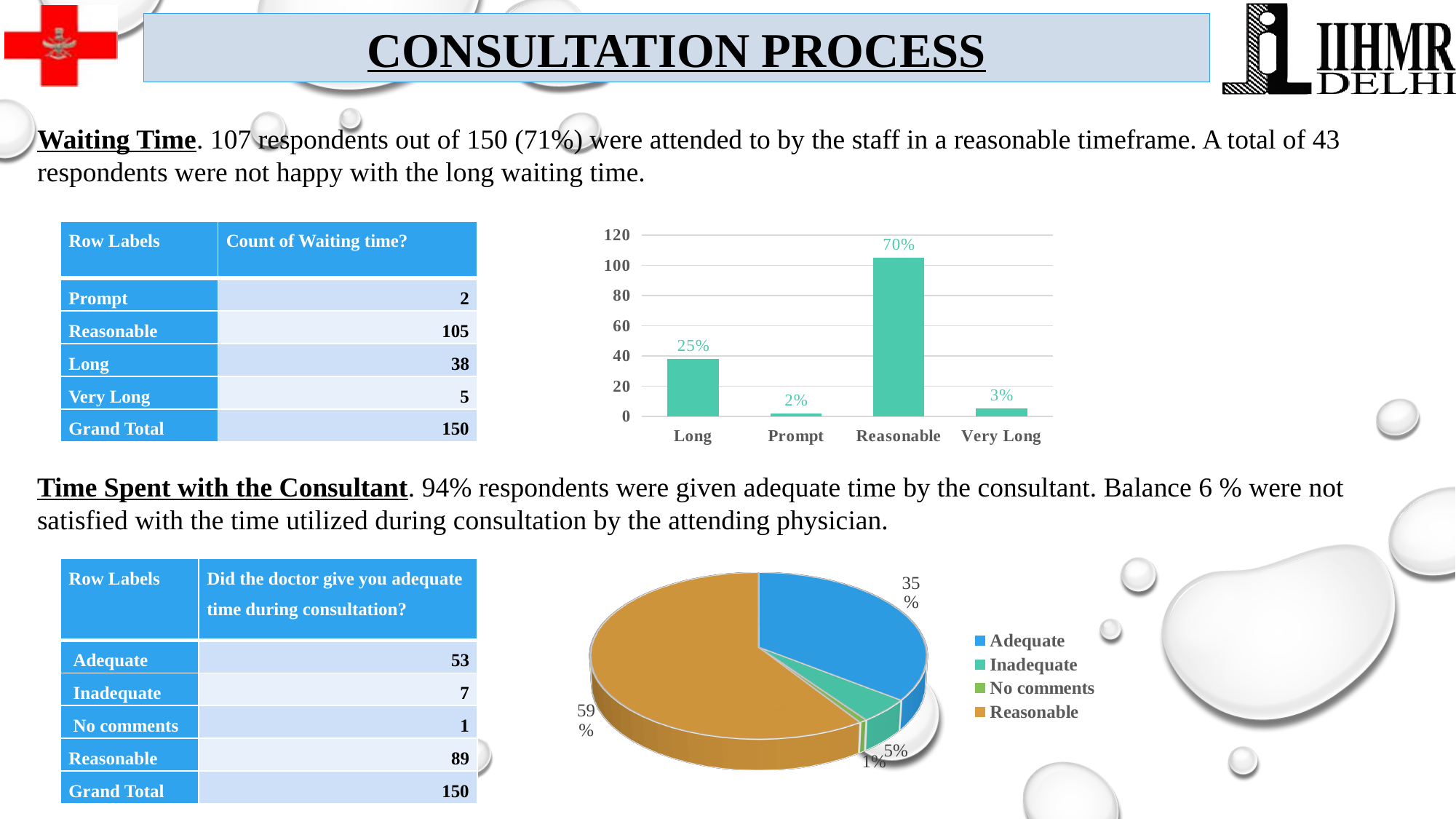
In the upper bar chart, is the value for Reasonable greater or less than 100? greater How many categories are shown on the x axis of the upper bar chart? 4 How many entries does the legend of the lower pie chart list? 4 What kind of chart is the lower chart on the slide (the time with consultant chart)? pie chart In the upper bar chart, which category has the shortest bar? Prompt In the lower pie chart, what share is labelled for the Adequate slice? 35% In the upper bar chart, which category has the tallest bar? Reasonable What kind of chart is the upper chart on the slide (the waiting time chart)? bar chart In the lower pie chart, what share is labelled for the Reasonable slice? 59% In the upper bar chart, what data label is shown above the Long bar? 25% In the upper bar chart, what data label is shown above the Reasonable bar? 70%